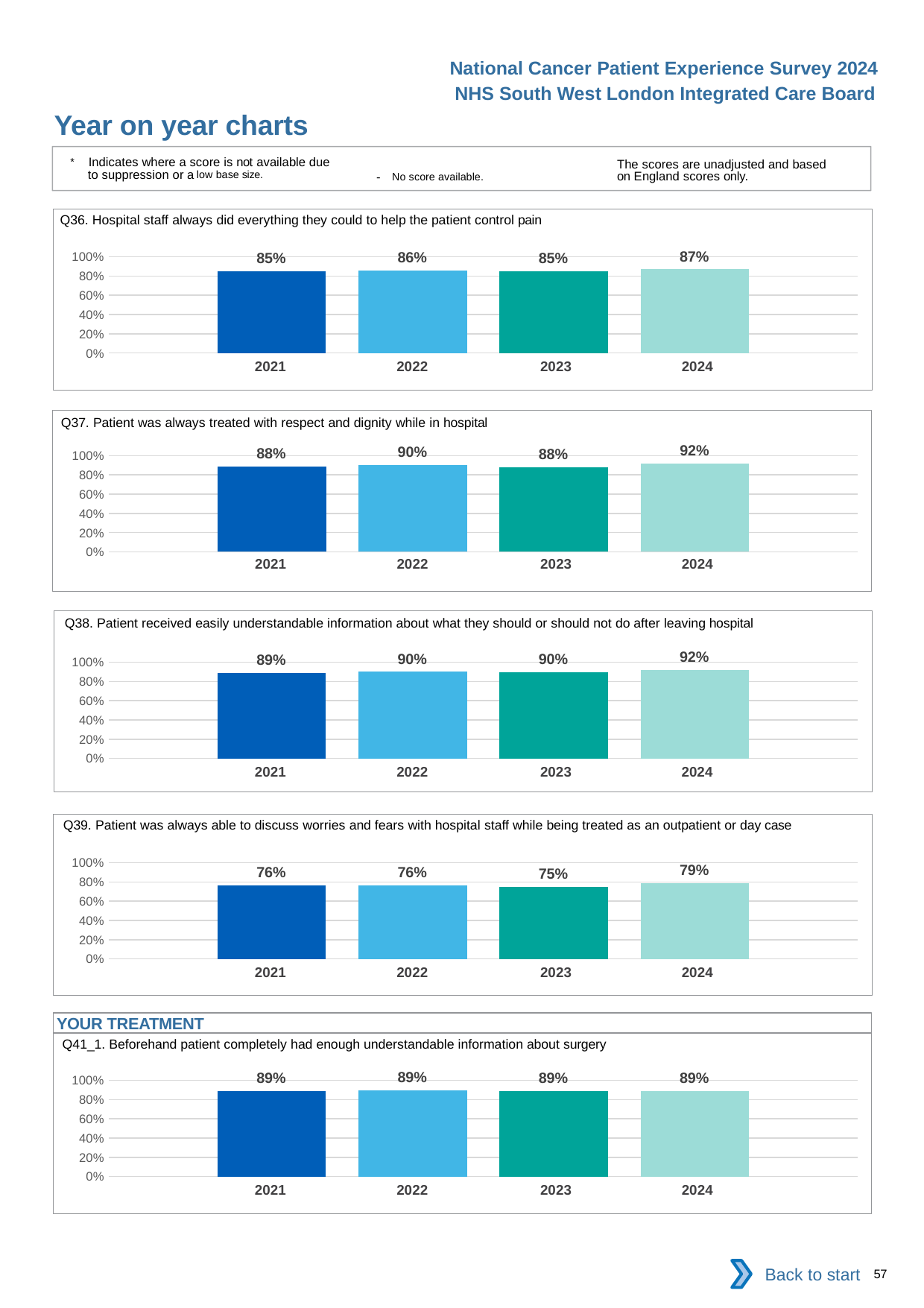
In the Q38 chart, what is the value for 2021? 89% In the Q41_1 chart, what is the value for 2023? 89% In the Q39 chart, is the value for 2022 greater or less than 80%? less In the Q37 chart, what is the difference between the 2024 and 2023 values? 4% How many years are shown in the Q38 chart? 4 What kind of chart is the Q37 chart? bar chart In the Q39 chart, which year has the lowest value? 2023 In the Q39 chart, what is the difference between the 2024 and 2021 values? 3% In the Q36 chart, what is the value for 2024? 87% In the Q36 chart, which is larger, the value for 2022 or the value for 2023? 2022 In the Q37 chart, which year has the highest value? 2024 How many charts are on the slide? 5